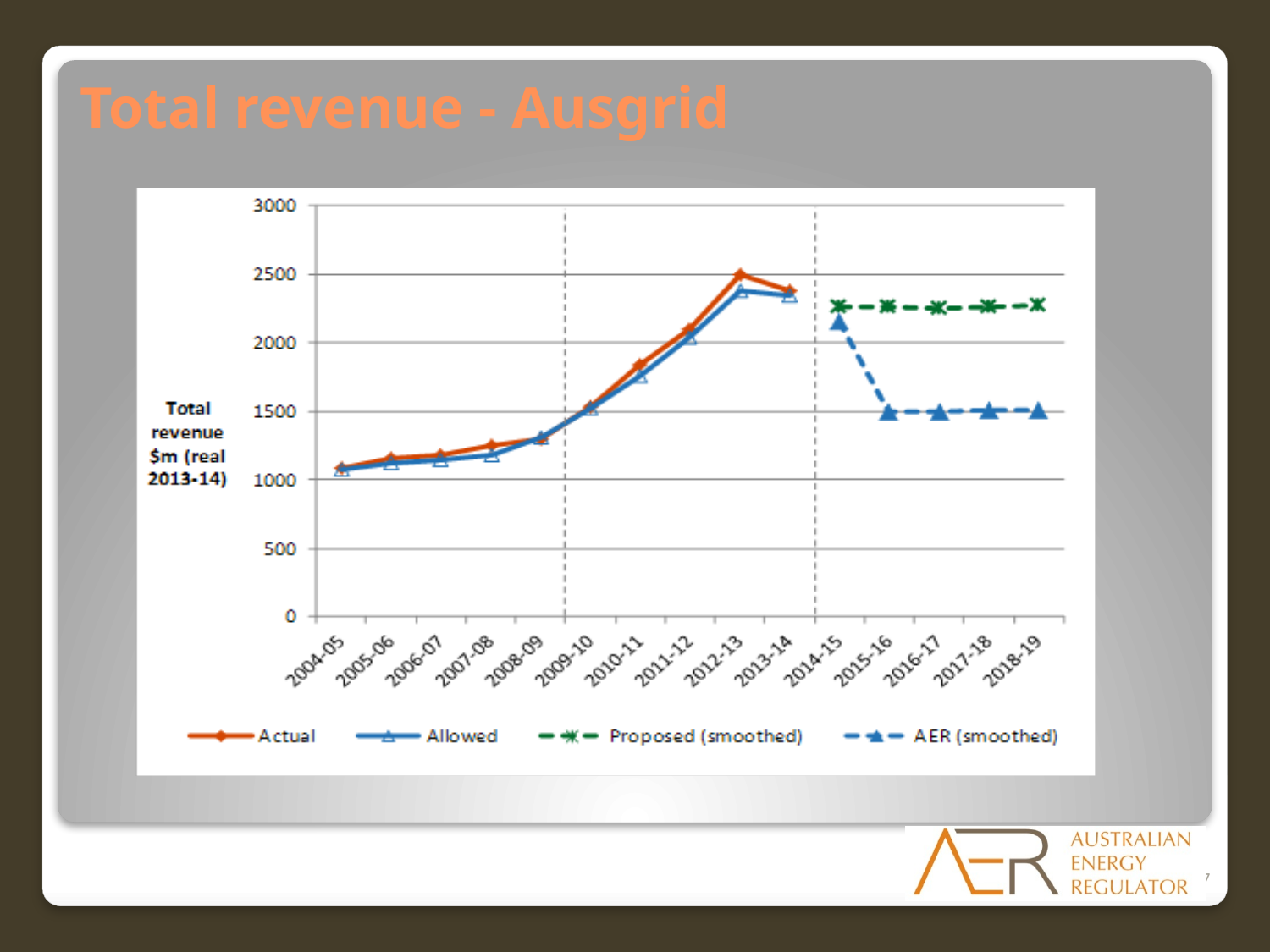
What is the title of the chart on the slide? Total revenue - Ausgrid What kind of chart is shown on the slide? Line chart What is the label on the vertical axis of the chart? Total revenue $m (real 2013-14) In 2016-17, which series is higher: Proposed (smoothed) or AER (smoothed)? Proposed (smoothed) Is the AER (smoothed) value for 2018-19 greater or less than 2000? less Is the Proposed (smoothed) value for 2018-19 greater or less than 2500? less Is the Actual value for 2012-13 greater or less than 2000? greater How many series does the chart legend list? 4 Does the Actual series rise or fall from 2004-05 to 2012-13? Rise In which year does the Actual series reach its highest value? 2012-13 How many financial years are shown along the x axis? 15